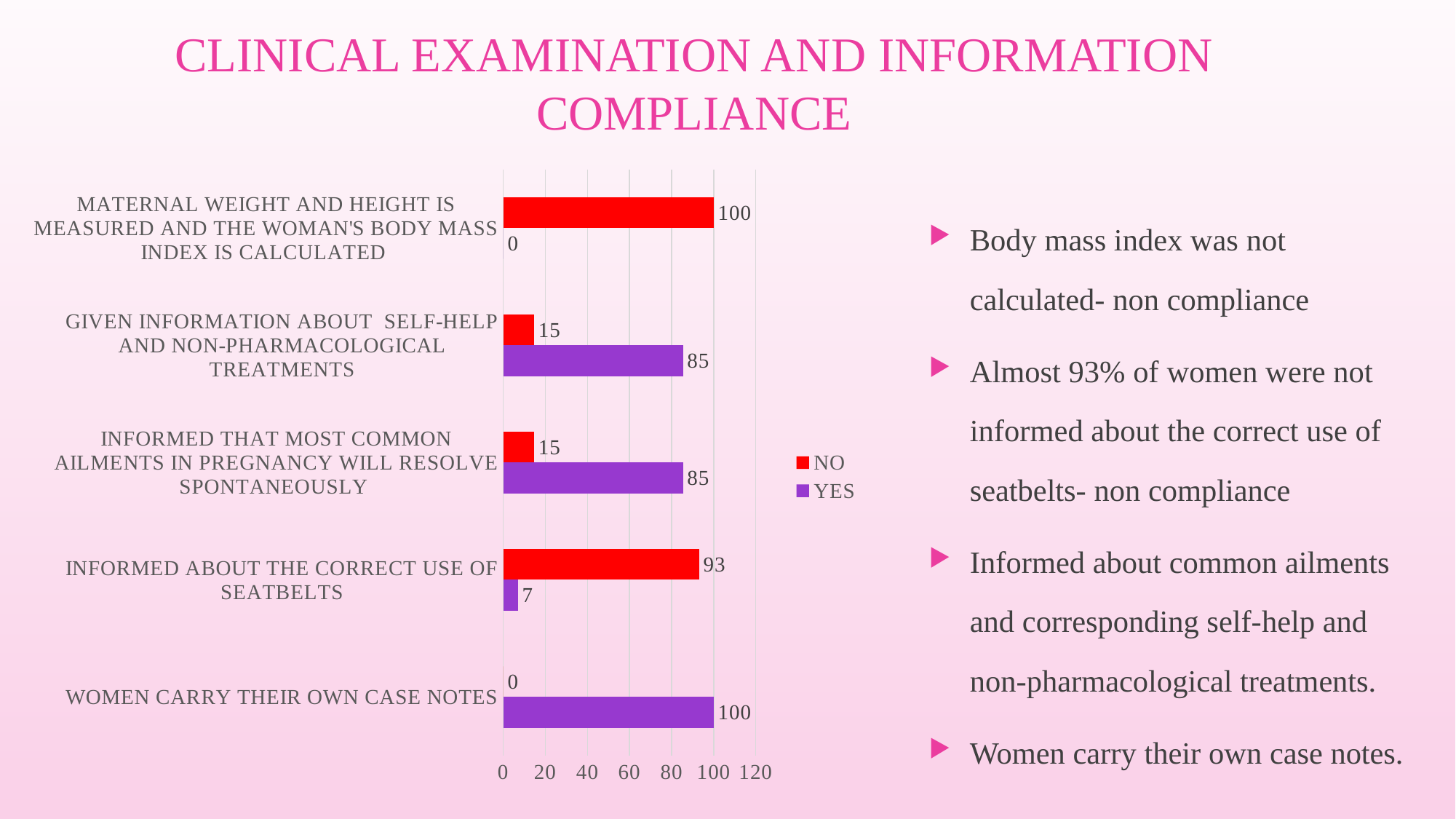
What is the NO value for 'Maternal weight and height is measured and the woman's body mass index is calculated'? 100 Which category has the lowest YES value? Maternal weight and height is measured and the woman's body mass index is calculated What is the YES value for 'Women carry their own case notes'? 100 How many categories are shown on the chart? 5 What kind of chart is shown on the slide? Bar chart How many series does the legend list? 2 Which category has the lowest NO value? Women carry their own case notes Which colour represents the YES series in the chart? Purple For 'Informed that most common ailments in pregnancy will resolve spontaneously', is the YES value or the NO value larger? YES What is the NO value for 'Informed about the correct use of seatbelts'? 93 What is the difference between the NO and YES values for 'Informed about the correct use of seatbelts'? 86 What is the YES value for 'Given information about self-help and non-pharmacological treatments'? 85